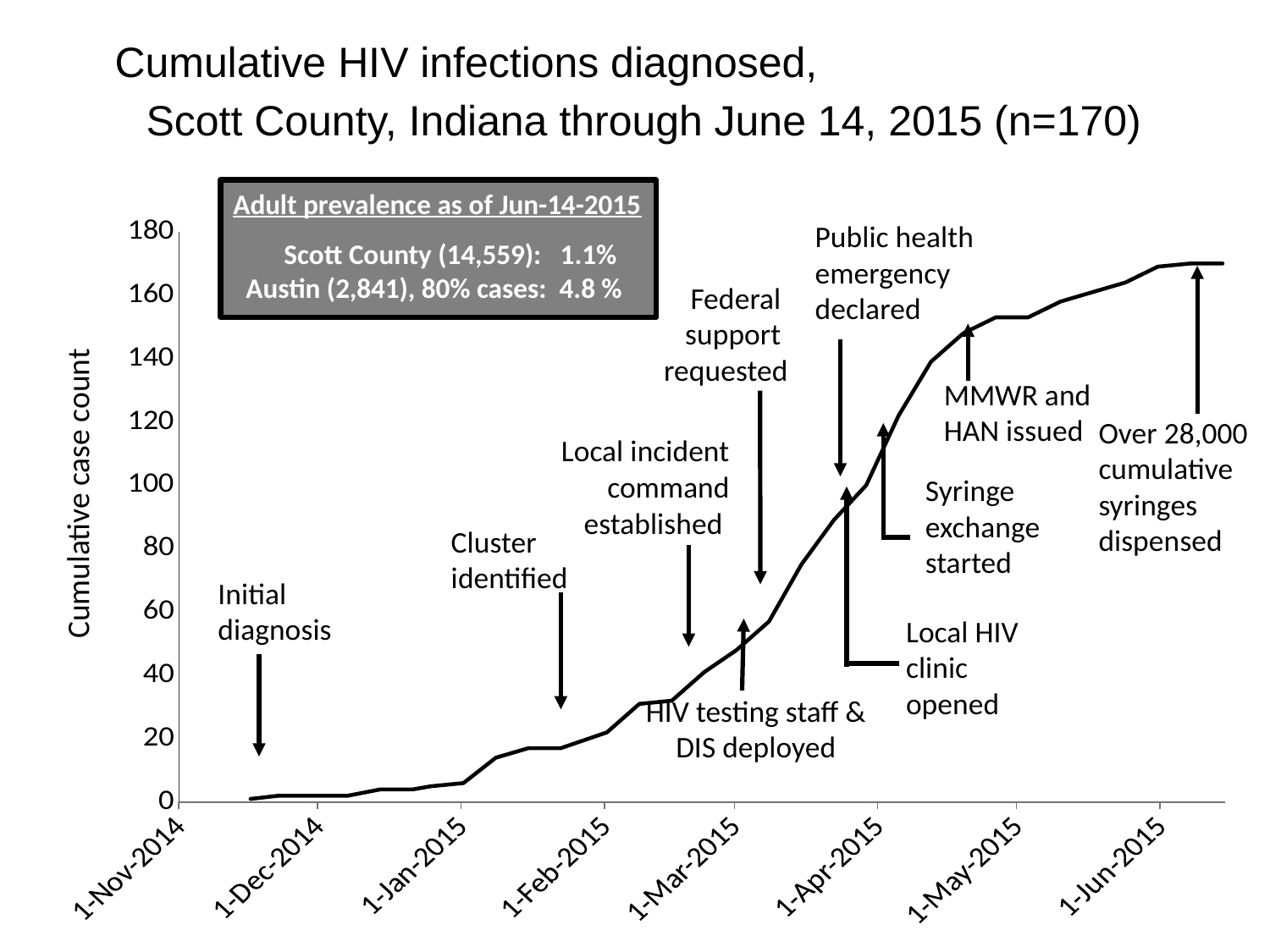
Which date has the higher cumulative case count, 1-Mar-2015 or 1-May-2015? 1-May-2015 What kind of chart is shown on the slide? line chart Is the cumulative case count at 1-Apr-2015 greater or less than 80? greater Does the cumulative case count rise or fall from 1-Nov-2014 to 1-Jun-2015? rise What is the label of the y axis? Cumulative case count Is the cumulative case count at 1-Mar-2015 greater or less than 60? less Is the cumulative case count at 1-Feb-2015 greater or less than 40? less What is the maximum value shown on the y axis? 180 How many date labels are shown on the x axis? 8